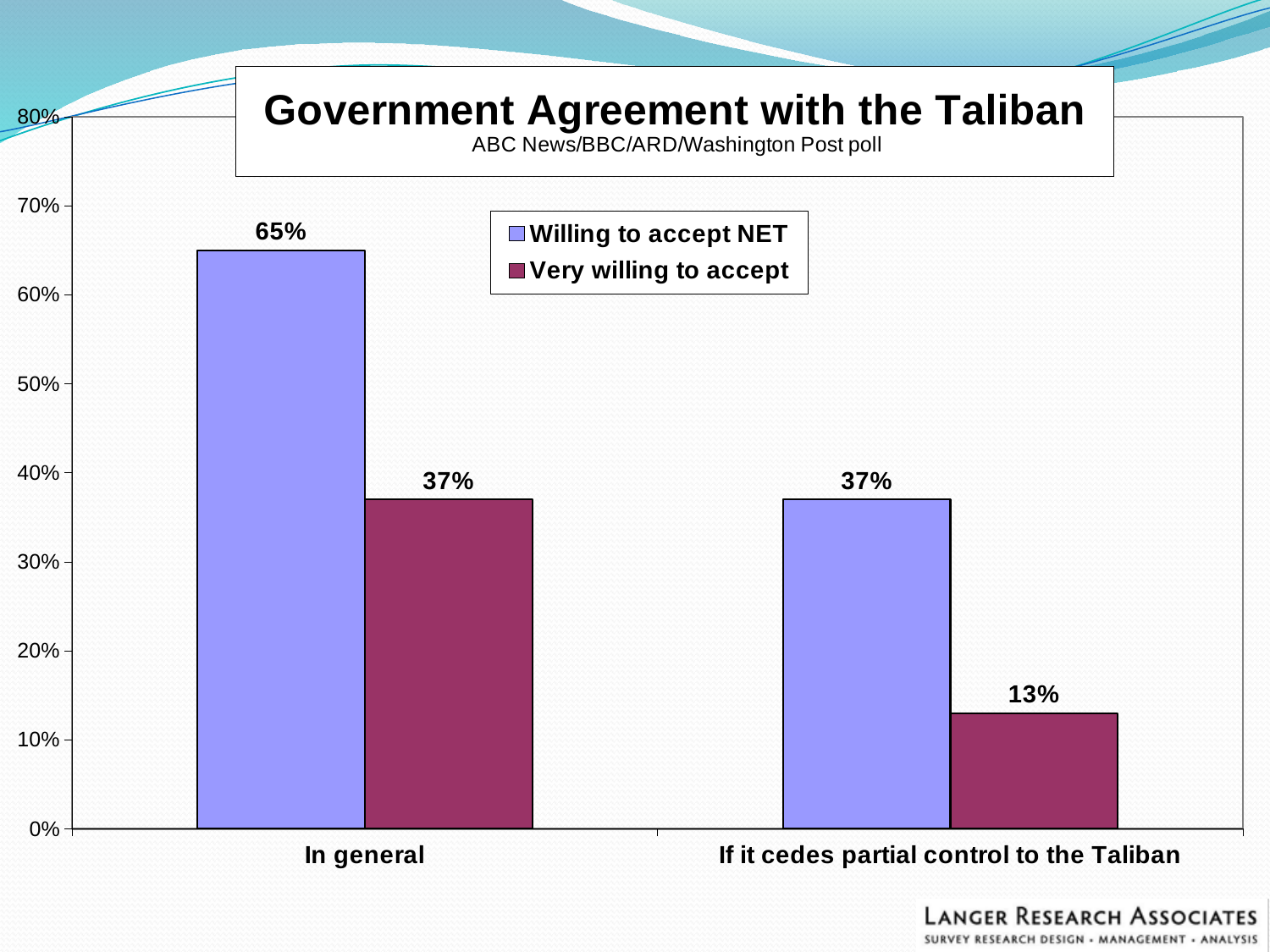
Which category has the lowest value for "Very willing to accept"? If it cedes partial control to the Taliban What is the difference between "Willing to accept NET" and "Very willing to accept" in the "In general" category? 28% What is the value for "Willing to accept NET" in the "In general" category? 65% Which category has the highest value for "Willing to accept NET"? In general What is the value for "Very willing to accept" in the "In general" category? 37% How many categories are shown on the x axis? 2 Which is larger: "Willing to accept NET" for "In general" or "Willing to accept NET" for "If it cedes partial control to the Taliban"? In general What is the value for "Willing to accept NET" in the "If it cedes partial control to the Taliban" category? 37% What kind of chart is shown on the slide? Bar chart What is the difference between "Willing to accept NET" and "Very willing to accept" in the "If it cedes partial control to the Taliban" category? 24% How many series does the legend list? 2 What is the value for "Very willing to accept" in the "If it cedes partial control to the Taliban" category? 13%